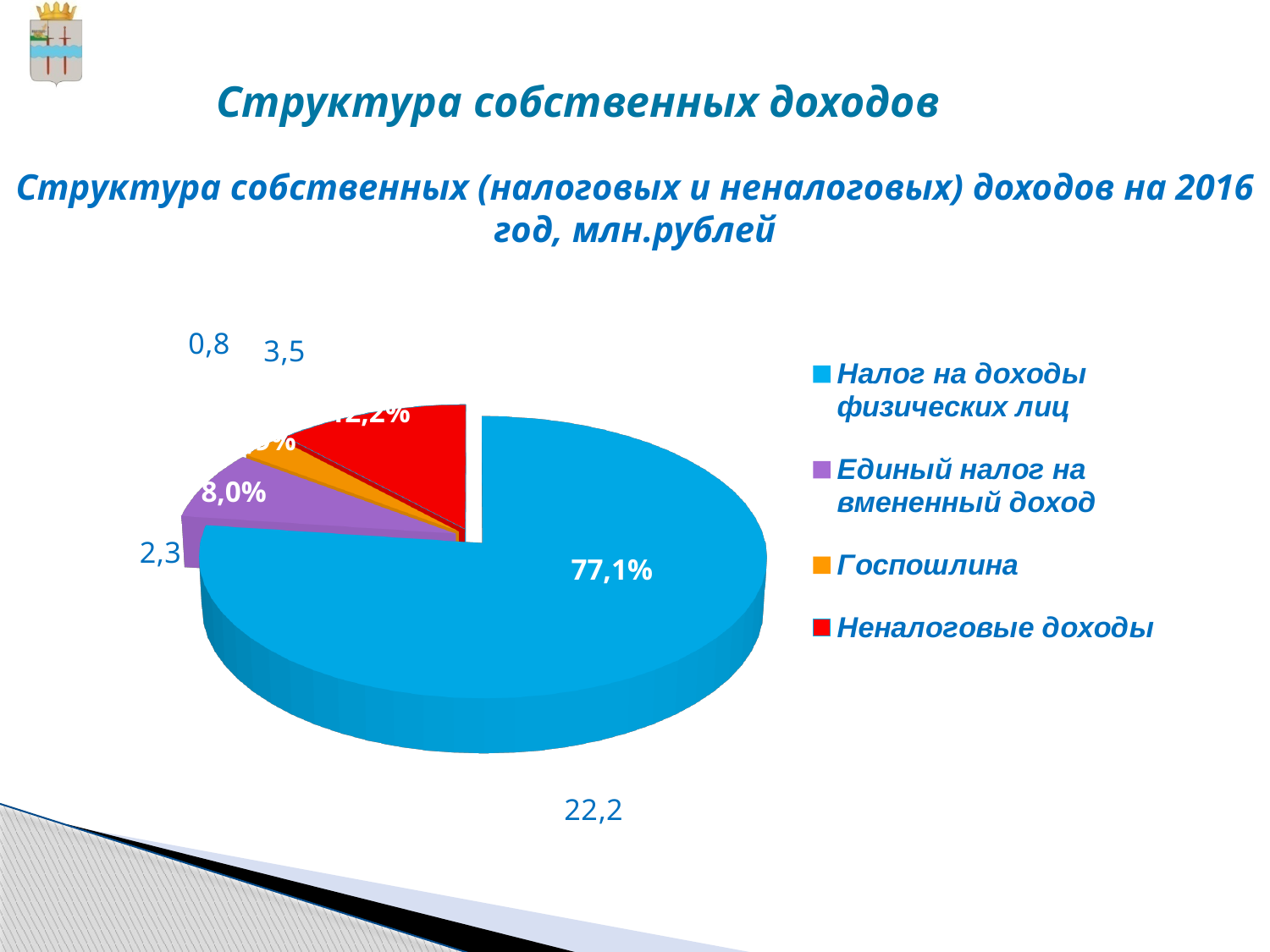
What is the value (млн.рублей) shown for Госпошлина? 0,8 What share of the pie does Налог на доходы физических лиц have? 77,1% Which category has the largest slice of the pie? Налог на доходы физических лиц What share of the pie does Единый налог на вмененный доход have? 8,0% What kind of chart is shown on the slide? pie chart Which category has the smallest slice of the pie? Госпошлина What is the value (млн.рублей) shown for Налог на доходы физических лиц? 22,2 How many categories does the legend of the pie chart list? 4 Which is larger: the value for Неналоговые доходы or the value for Единый налог на вмененный доход? Неналоговые доходы What is the value (млн.рублей) shown for Неналоговые доходы? 3,5 What colour is the Госпошлина slice in the pie chart? orange What is the difference between the value for Налог на доходы физических лиц (22,2) and the value for Единый налог на вмененный доход (2,3)? 19,9